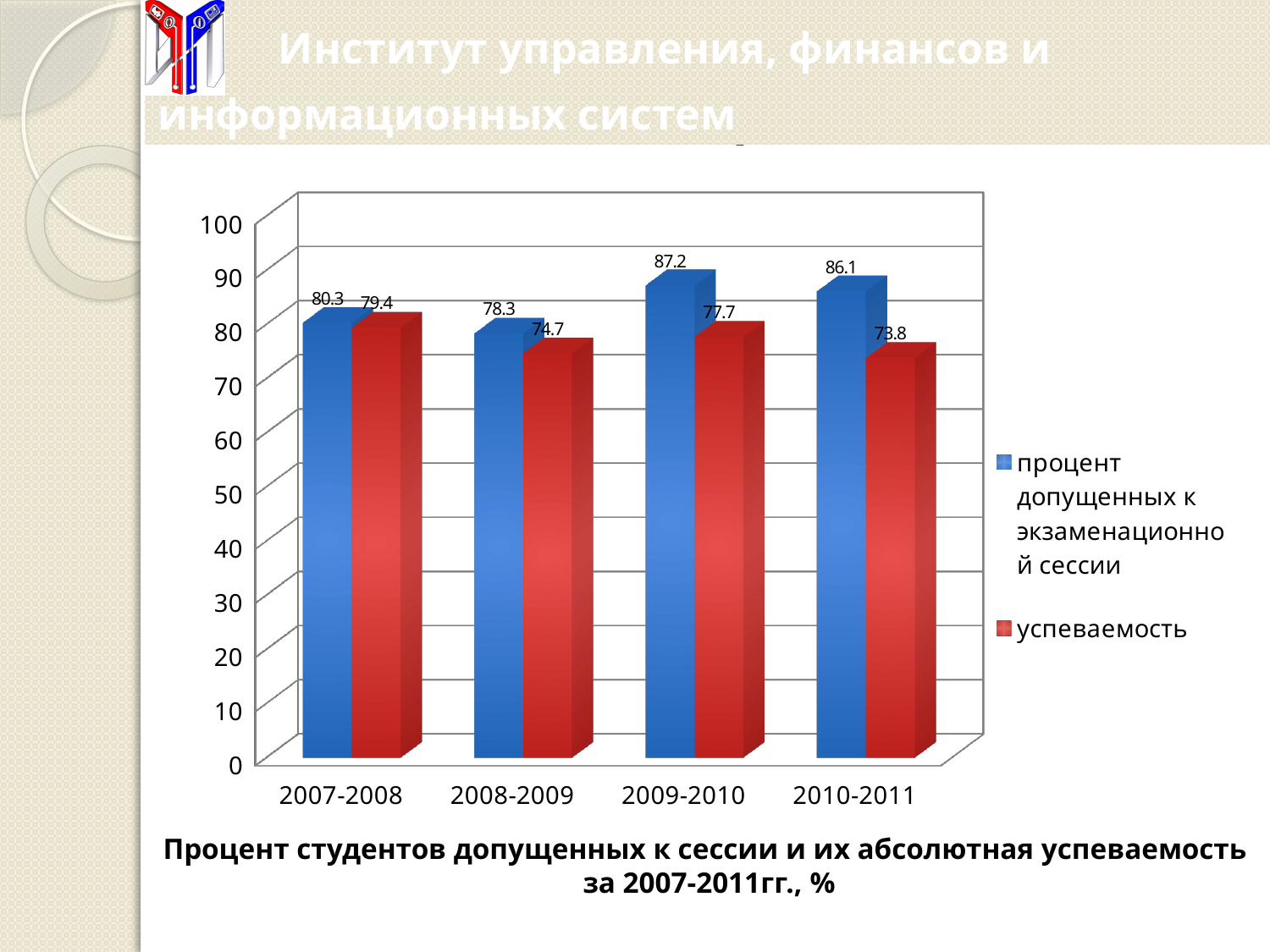
In which academic year is "успеваемость" the lowest? 2010-2011 Which colour represents "успеваемость" in the chart? red What is the value of "успеваемость" for 2010-2011? 73.8 What is the value of "процент допущенных к экзаменационной сессии" for 2009-2010? 87.2 What kind of chart is shown on the slide? bar chart Is the value of "успеваемость" for 2008-2009 greater or less than 80? less How many academic years are shown on the x axis? 4 How many series does the legend list? 2 Which is larger in 2008-2009: "процент допущенных к экзаменационной сессии" or "успеваемость"? процент допущенных к экзаменационной сессии What is the difference between "процент допущенных к экзаменационной сессии" and "успеваемость" in 2010-2011? 12.3 What is the value of "успеваемость" for 2007-2008? 79.4 In which academic year is "процент допущенных к экзаменационной сессии" the highest? 2009-2010